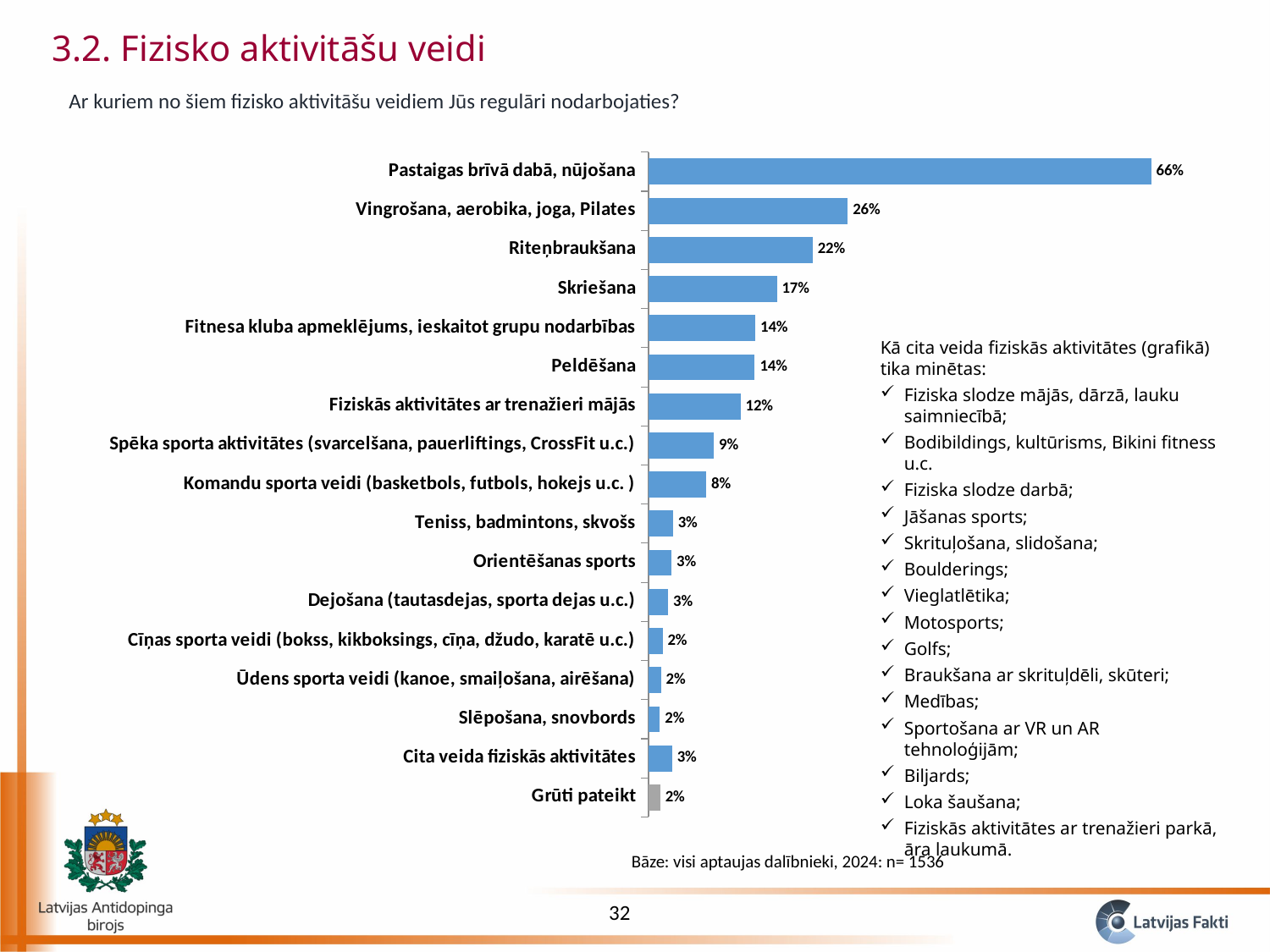
How many categories are shown in the bar chart? 17 What is the difference between 'Riteņbraukšana' and 'Skriešana'? 5% What is the value shown for 'Grūti pateikt'? 2% What percentage of respondents regularly do 'Pastaigas brīvā dabā, nūjošana'? 66% Which activity has the highest value in the chart? Pastaigas brīvā dabā, nūjošana Which bar in the chart is coloured grey rather than blue? Grūti pateikt Which is larger: 'Fiziskās aktivitātes ar trenažieri mājās' or 'Komandu sporta veidi (basketbols, futbols, hokejs u.c. )'? Fiziskās aktivitātes ar trenažieri mājās What is the value shown for 'Riteņbraukšana'? 22% What is the difference between 'Pastaigas brīvā dabā, nūjošana' and 'Vingrošana, aerobika, joga, Pilates'? 40% What is the value shown for 'Skriešana'? 17% What is the value shown for 'Peldēšana'? 14% What type of chart is shown on the slide? Bar chart